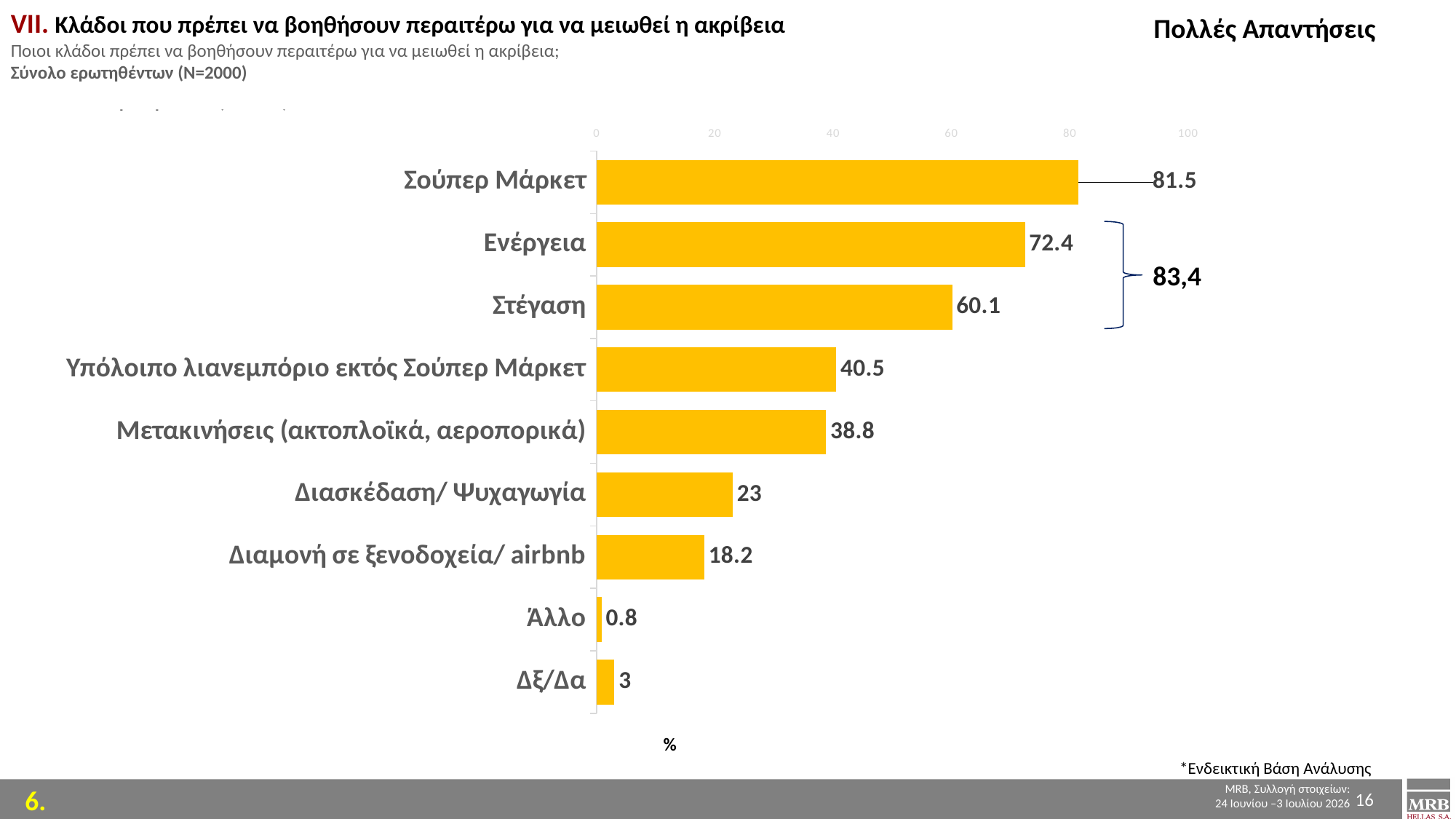
What is the value for Σούπερ Μάρκετ? 81.5 What kind of chart is shown on the slide? bar chart Is the value for Στέγαση greater or less than 60? greater What combined value is shown by the bracket grouping Ενέργεια and Στέγαση? 83,4 What is the value for Μετακινήσεις (ακτοπλοϊκά, αεροπορικά)? 38.8 What is the difference between the values for Ενέργεια and Στέγαση? 12.3 Which category has the highest value? Σούπερ Μάρκετ What is the value for Διαμονή σε ξενοδοχεία/ airbnb? 18.2 Which is larger, the value for Υπόλοιπο λιανεμπόριο εκτός Σούπερ Μάρκετ or the value for Μετακινήσεις (ακτοπλοϊκά, αεροπορικά)? Υπόλοιπο λιανεμπόριο εκτός Σούπερ Μάρκετ Which category has the lowest value? Άλλο How many categories are shown in the chart? 9 What is the value for Ενέργεια? 72.4